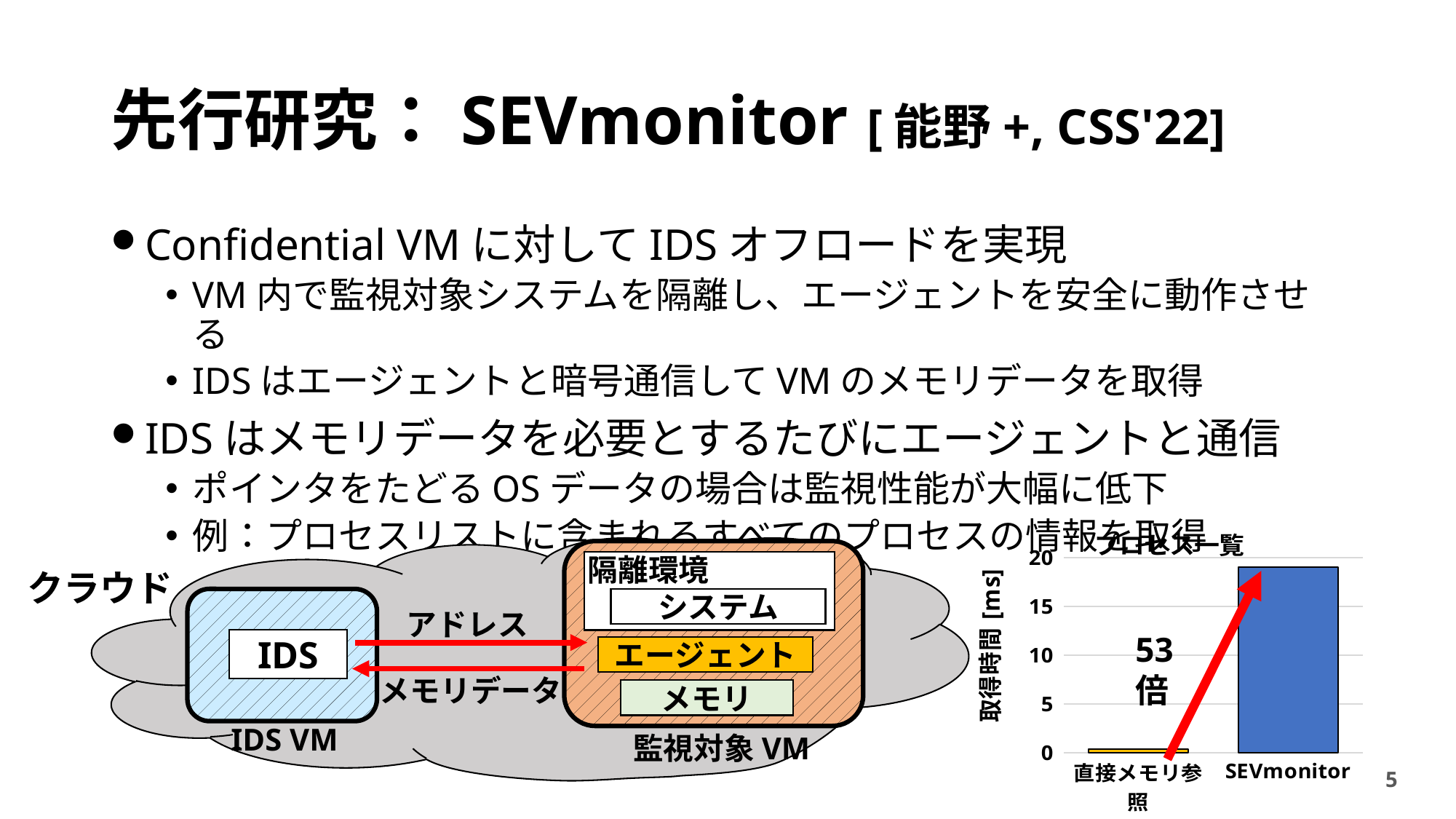
What kind of chart is shown at the bottom right of the slide? bar chart In the bar chart at the bottom right, which is larger: the value for SEVmonitor or the value for 直接メモリ参照? SEVmonitor In the bar chart at the bottom right, is the value for 直接メモリ参照 greater or less than 5? less What ratio is annotated between the two bars in the bar chart at the bottom right? 53倍 In the bar chart at the bottom right, is the value for SEVmonitor greater or less than 20? less In the bar chart at the bottom right, is the value for SEVmonitor greater or less than 15? greater In the bar chart at the bottom right, which category has the highest 取得時間? SEVmonitor In the bar chart at the bottom right, which category has the lowest 取得時間? 直接メモリ参照 What is the y-axis label of the bar chart at the bottom right? 取得時間 [ms] How many categories are plotted in the bar chart at the bottom right? 2